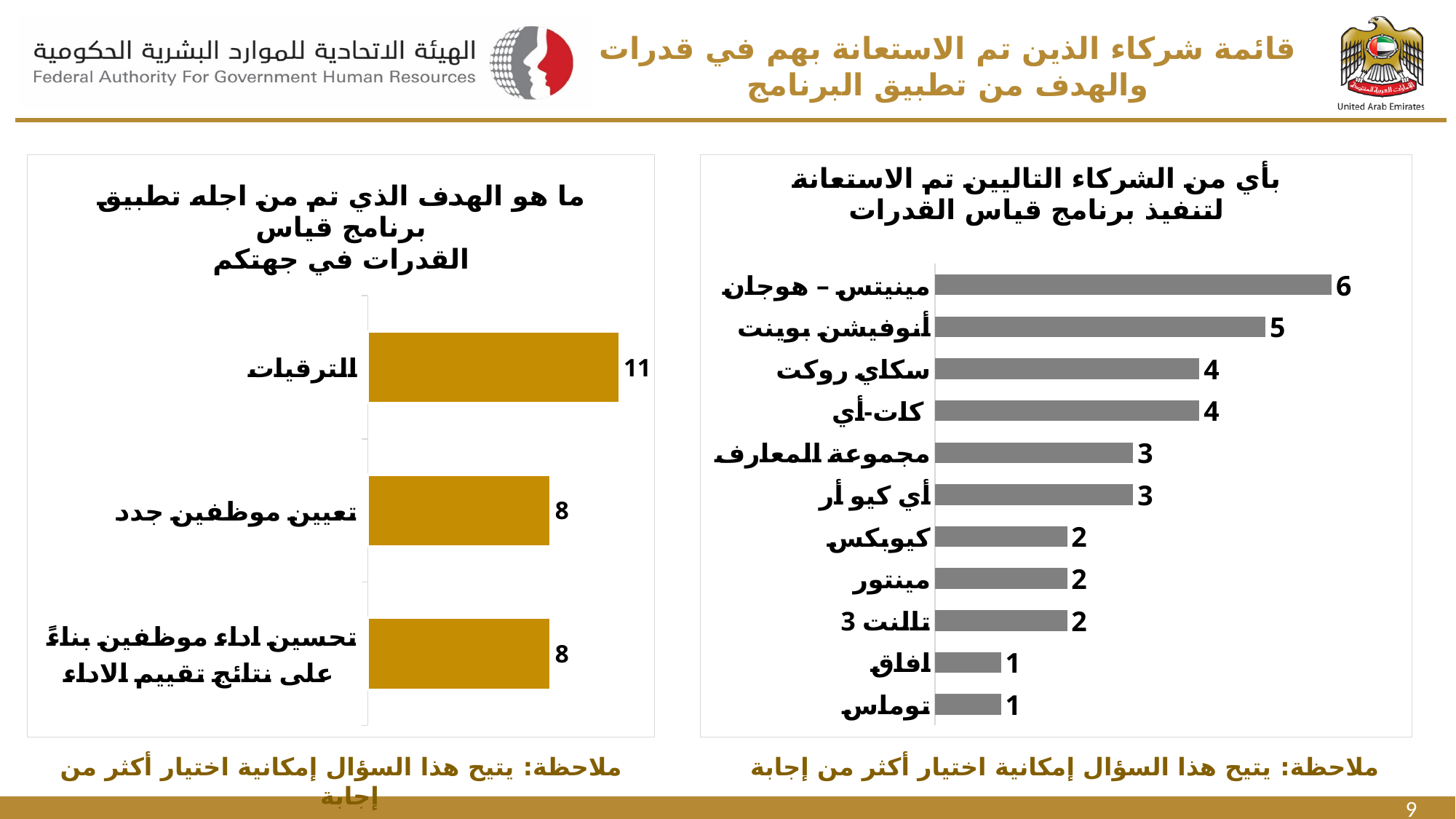
In the right-hand chart, which partner has the highest value? مينيتس - هوجان In the right-hand chart, what is the difference between the values for مينيتس - هوجان and كيوبكس? 4 In the left-hand chart, which category has the highest value? الترقيات In the left-hand chart, how many categories are shown? 3 In the right-hand chart (بأي من الشركاء التاليين تم الاستعانة لتنفيذ برنامج قياس القدرات), what is the value for مينيتس - هوجان? 6 In the right-hand chart, what is the value for أنوفيشن بوينت? 5 What type of chart is the left-hand chart? Bar chart In the right-hand chart, how many partner categories are shown? 11 In the right-hand chart, which is larger: the value for سكاي روكت or the value for مجموعة المعارف? سكاي روكت In the right-hand chart, what is the value for توماس? 1 In the left-hand chart (ما هو الهدف الذي تم من اجله تطبيق برنامج قياس القدرات في جهتكم), what is the value for الترقيات? 11 In the left-hand chart, what is the difference between the values for الترقيات and تعيين موظفين جدد? 3